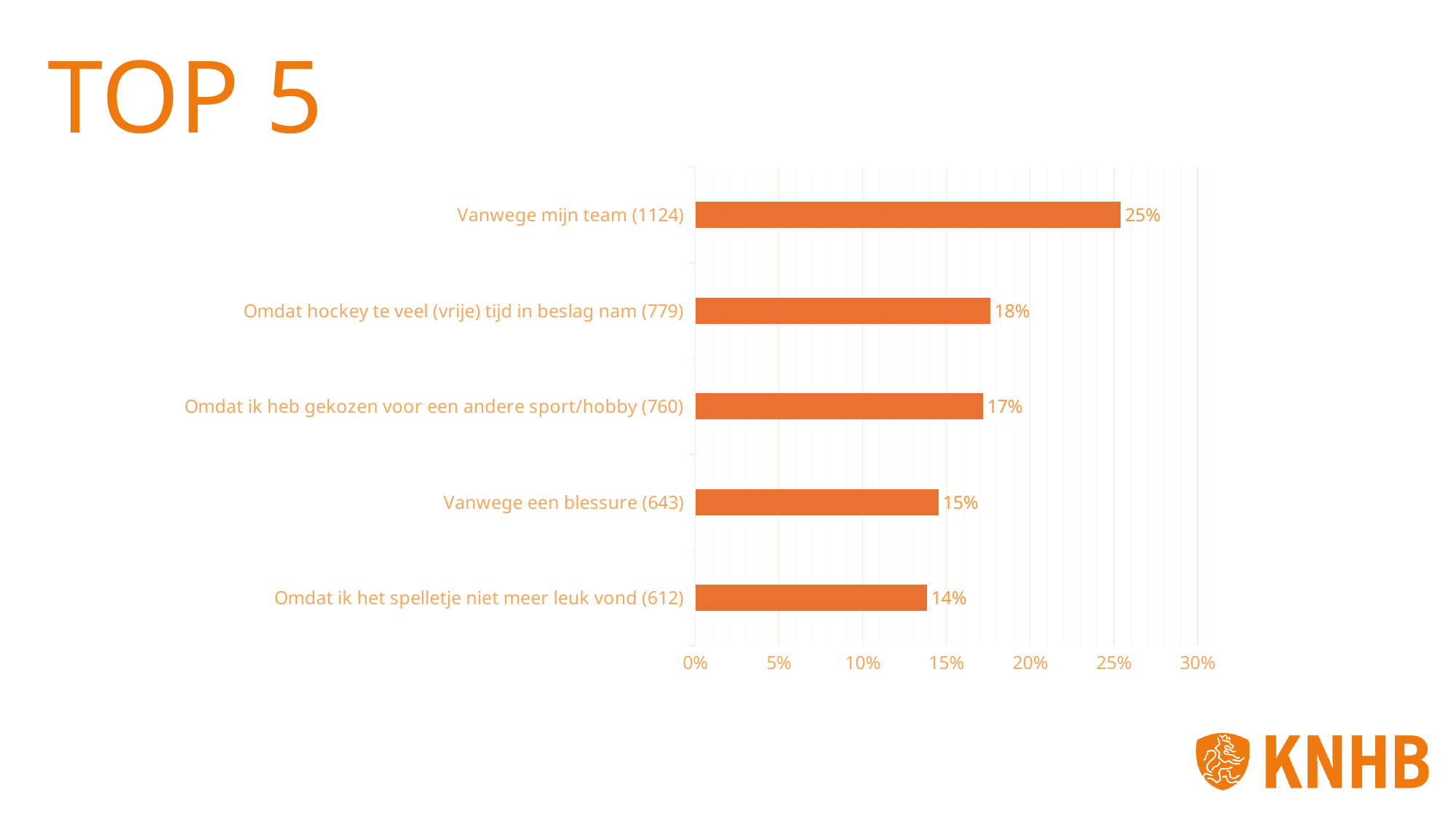
What kind of chart is shown on the slide? bar chart What is the value for "Omdat ik het spelletje niet meer leuk vond (612)"? 14% Which category has the highest value? Vanwege mijn team (1124) Which is larger: the value for "Omdat hockey te veel (vrije) tijd in beslag nam (779)" or for "Omdat ik heb gekozen voor een andere sport/hobby (760)"? Omdat hockey te veel (vrije) tijd in beslag nam (779) Which category has the lowest value? Omdat ik het spelletje niet meer leuk vond (612) What is the title of the slide? TOP 5 What is the difference between the values for "Vanwege mijn team (1124)" and "Omdat hockey te veel (vrije) tijd in beslag nam (779)"? 7% What is the maximum value shown on the x axis? 30% What is the value for "Vanwege een blessure (643)"? 15% What is the value for "Vanwege mijn team (1124)"? 25% How many categories are shown in the chart? 5 Is the value for "Vanwege mijn team (1124)" greater or less than 20%? greater